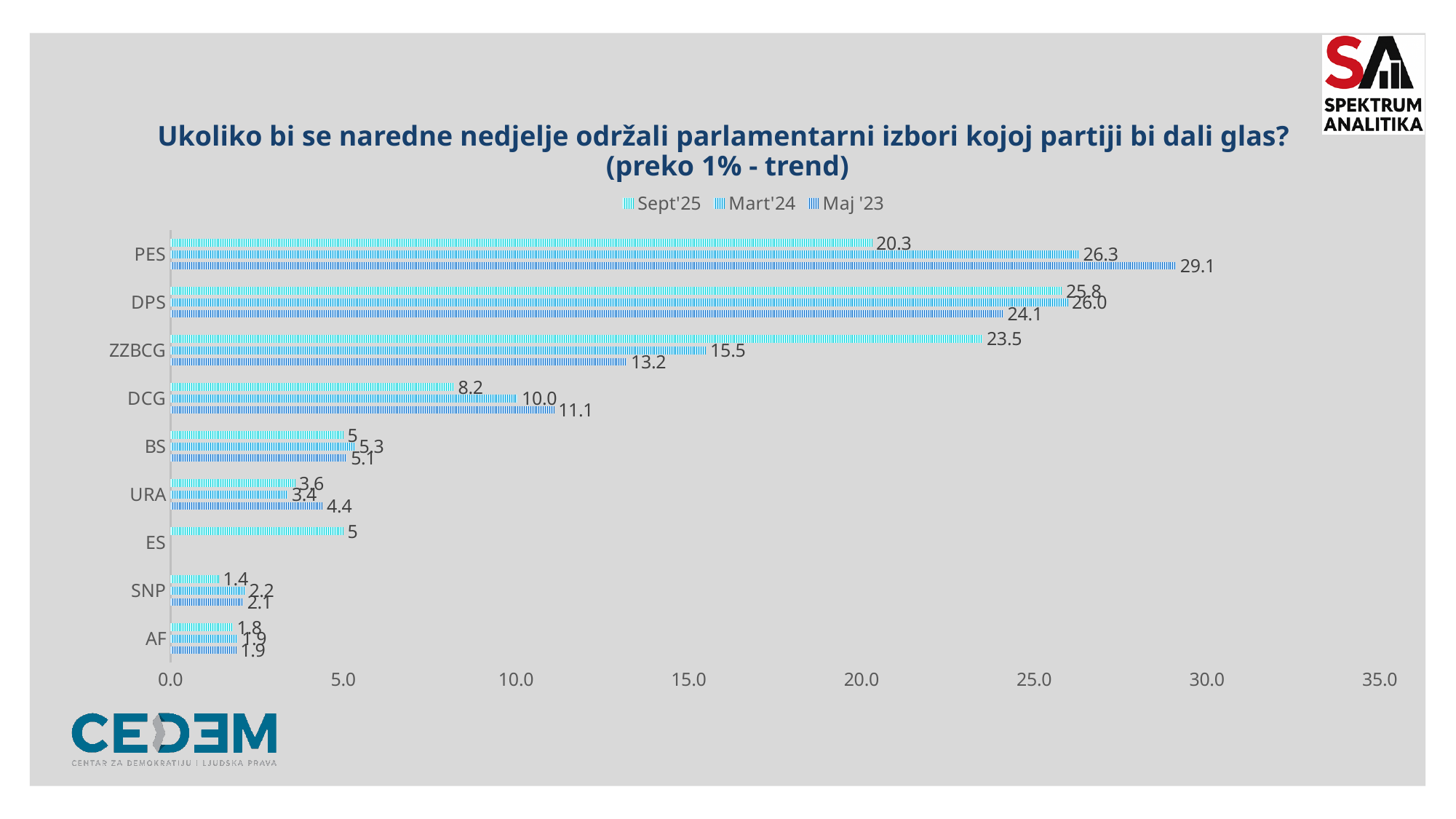
How many parties (categories) are shown on the chart? 9 What is the Maj '23 value for DPS? 24.1 How many series does the legend list? 3 What type of chart is shown on the slide? bar chart Which party has the highest Sept'25 value? DPS What is the difference between the Maj '23 and Sept'25 values for PES? 8.8 Which party has the lowest Sept'25 value? SNP Do the values for ZZBCG rise or fall from Maj '23 to Sept'25? rise What is the Mart'24 value for ZZBCG? 15.5 Which party has a value only for the Sept'25 series? ES Which is larger for DCG: the Mart'24 value or the Sept'25 value? Mart'24 What is the Sept'25 value for PES? 20.3